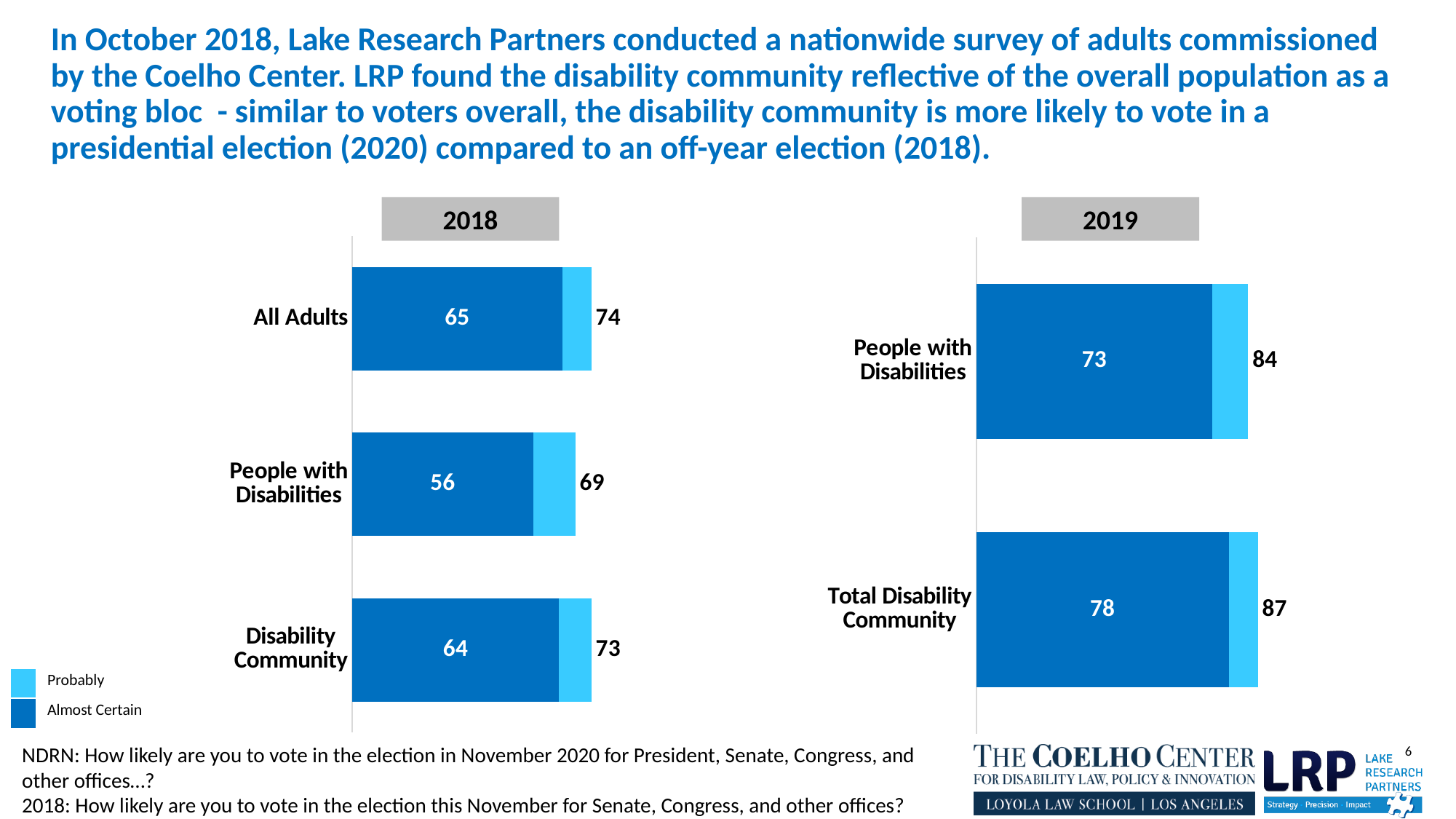
In the 2019 chart, which category has the higher total value? Total Disability Community In the 2019 chart, what is the Almost Certain value for Total Disability Community? 78 In the 2018 chart, is the Almost Certain value for Disability Community larger or smaller than that for All Adults? smaller In the 2018 chart, which category has the lowest Almost Certain value? People with Disabilities What kind of chart is used on this slide? Stacked bar chart In the 2018 chart, what is the total value shown at the end of the bar for People with Disabilities? 69 How many categories are shown in the 2018 chart? 3 In the 2018 chart, what is the Almost Certain value for All Adults? 65 In the 2018 chart, how much of the All Adults total of 74 comes from the Probably segment, given the Almost Certain value is 65? 9 In the 2018 chart, what is the difference between the total for All Adults and the total for People with Disabilities? 5 In the 2019 chart, what is the total value shown at the end of the bar for People with Disabilities? 84 How many series does the legend list? 2